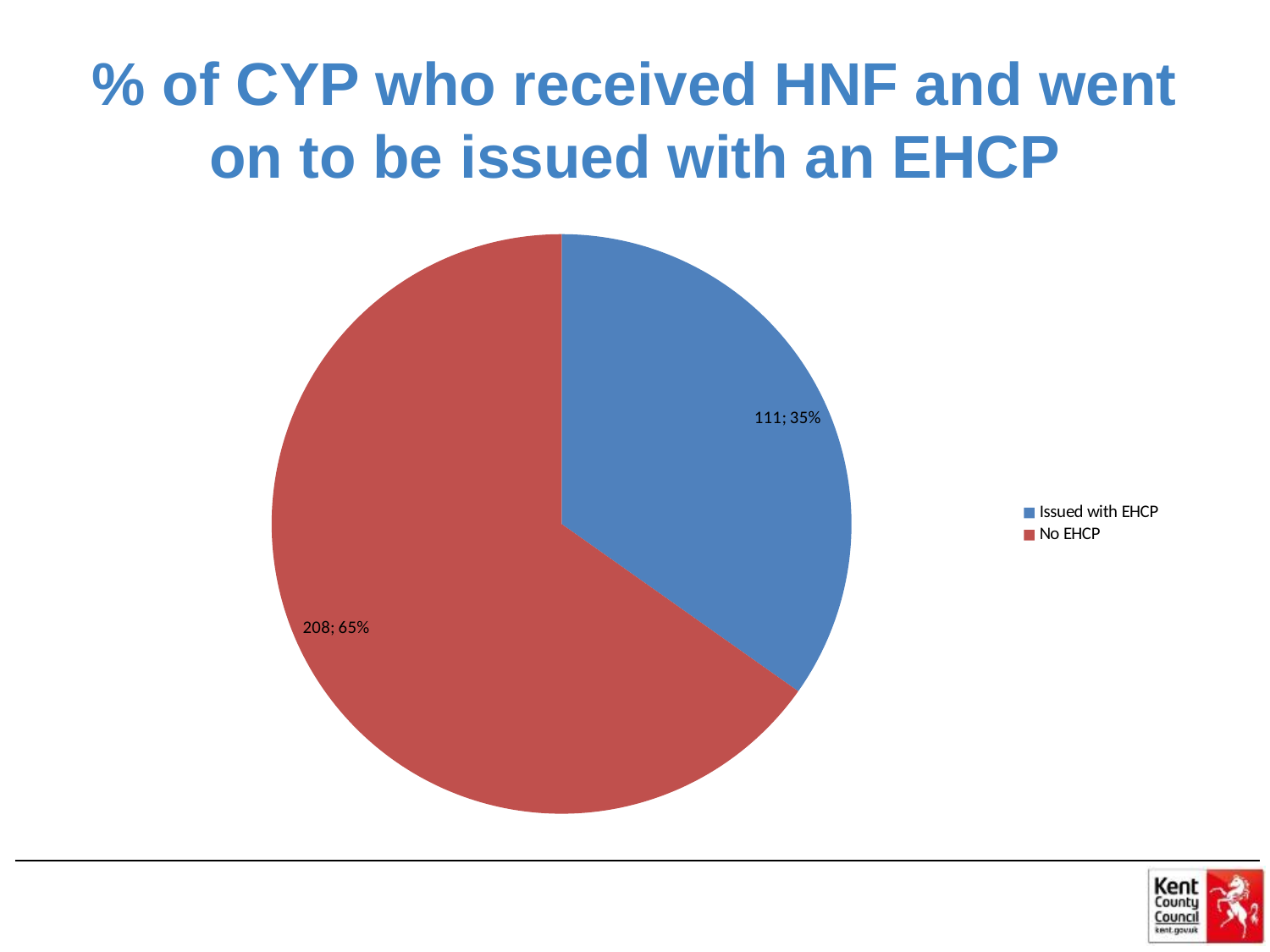
How many CYP were issued with an EHCP? 111 What percentage of CYP were issued with an EHCP? 35% How many CYP had no EHCP? 208 Which category has the smallest slice? Issued with EHCP What colour is the Issued with EHCP slice? blue How many categories does the pie chart have? 2 Which category has the largest slice? No EHCP What is the difference between the number of CYP with No EHCP and those Issued with EHCP? 97 Which is larger: the number Issued with EHCP or the number with No EHCP? No EHCP What share of the pie does the No EHCP slice represent? 65% What is the total number of CYP represented in the pie chart? 319 What kind of chart is shown on the slide? pie chart